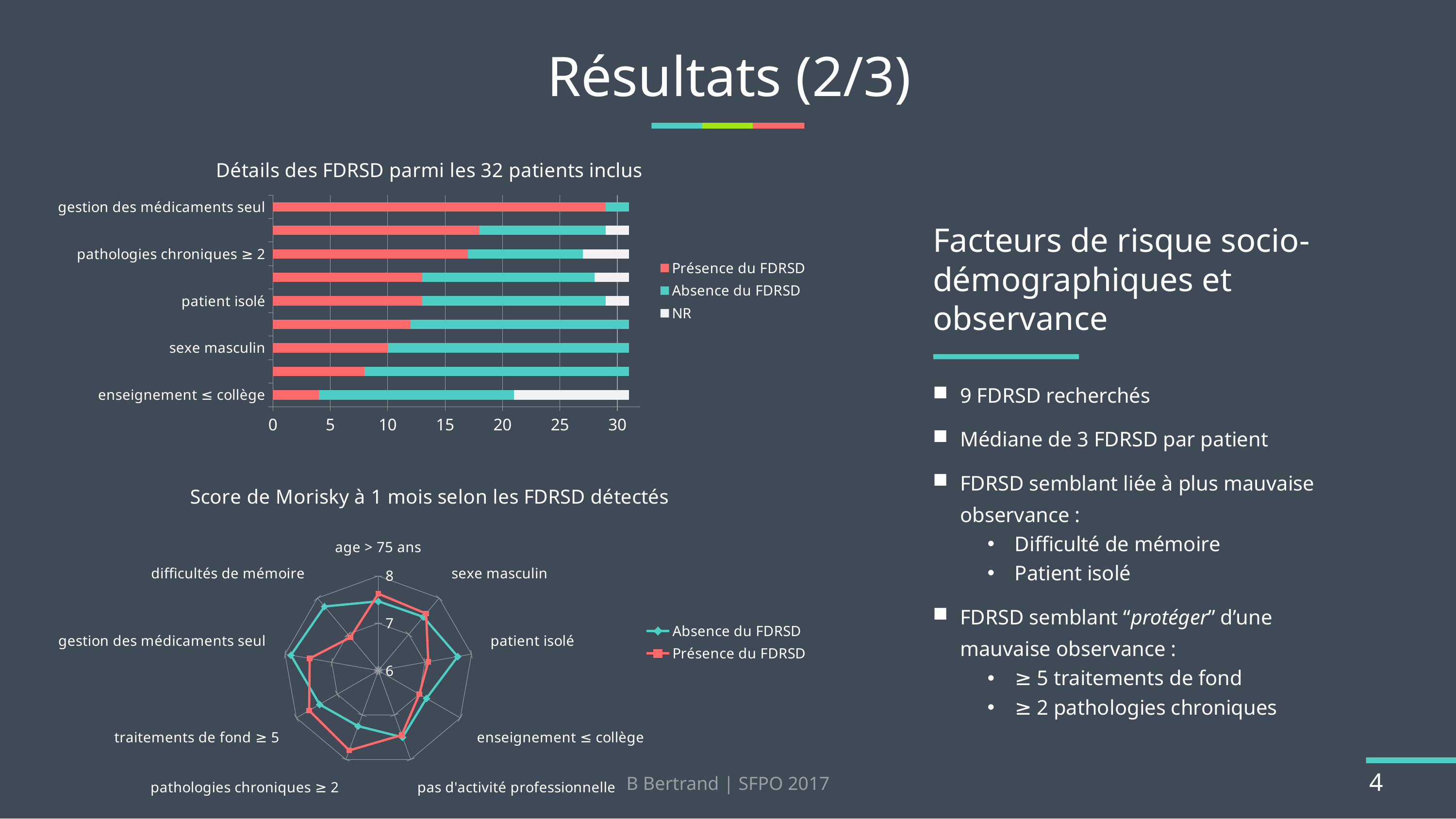
In the top chart 'Détails des FDRSD parmi les 32 patients inclus', how many series does the legend list? 3 In the bottom chart 'Score de Morisky à 1 mois selon les FDRSD détectés', how many axes (categories) does the radar have? 9 In the top chart 'Détails des FDRSD parmi les 32 patients inclus', which labelled category has the highest 'Présence du FDRSD' value? gestion des médicaments seul What kind of chart is the top chart titled 'Détails des FDRSD parmi les 32 patients inclus'? Stacked bar chart In the top chart 'Détails des FDRSD parmi les 32 patients inclus', is the 'Présence du FDRSD' value for 'enseignement ≤ collège' greater or less than 5? less In the bottom chart 'Score de Morisky à 1 mois selon les FDRSD détectés', for 'gestion des médicaments seul', which series has the higher score: 'Absence du FDRSD' or 'Présence du FDRSD'? Absence du FDRSD In the bottom chart 'Score de Morisky à 1 mois selon les FDRSD détectés', how many series does the legend list? 2 In the top chart 'Détails des FDRSD parmi les 32 patients inclus', is the 'Présence du FDRSD' value for 'gestion des médicaments seul' greater or less than 25? greater In the bottom chart 'Score de Morisky à 1 mois selon les FDRSD détectés', for 'pathologies chroniques ≥ 2', which series has the higher score: 'Absence du FDRSD' or 'Présence du FDRSD'? Présence du FDRSD In the top chart 'Détails des FDRSD parmi les 32 patients inclus', which labelled category has the lowest 'Présence du FDRSD' value? enseignement ≤ collège What kind of chart is the bottom chart titled 'Score de Morisky à 1 mois selon les FDRSD détectés'? Radar chart In the top chart 'Détails des FDRSD parmi les 32 patients inclus', how many bars (categories) are plotted? 9